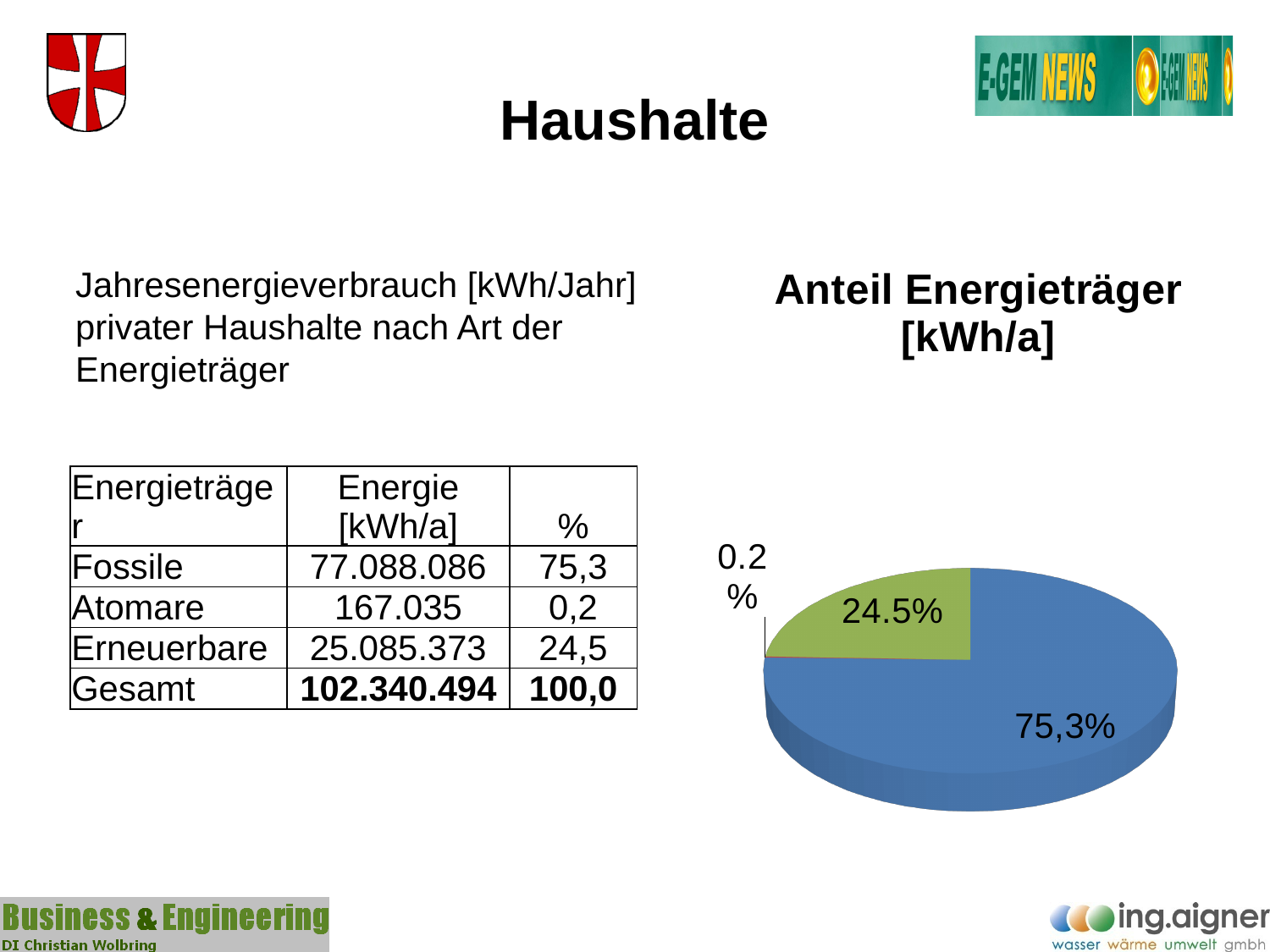
What is the share shown on the smallest slice of the pie chart? 0.2% According to the table on the slide, which energy carrier does the 24.5% slice of the pie chart represent? Erneuerbare What share is printed on the blue slice of the pie chart? 75,3% What colour is the largest slice of the pie chart? blue What share is printed on the green slice of the pie chart? 24.5% According to the table on the slide, which energy carrier does the 75,3% slice of the pie chart represent? Fossile How many slices does the pie chart have? 3 Is the share of the largest slice in the pie chart greater or less than 50%? greater What kind of chart is shown on the slide? pie chart Which slice is larger in the pie chart, the blue one or the green one? the blue one What is the title of the pie chart? Anteil Energieträger [kWh/a] What is the share shown on the largest slice of the pie chart? 75,3%